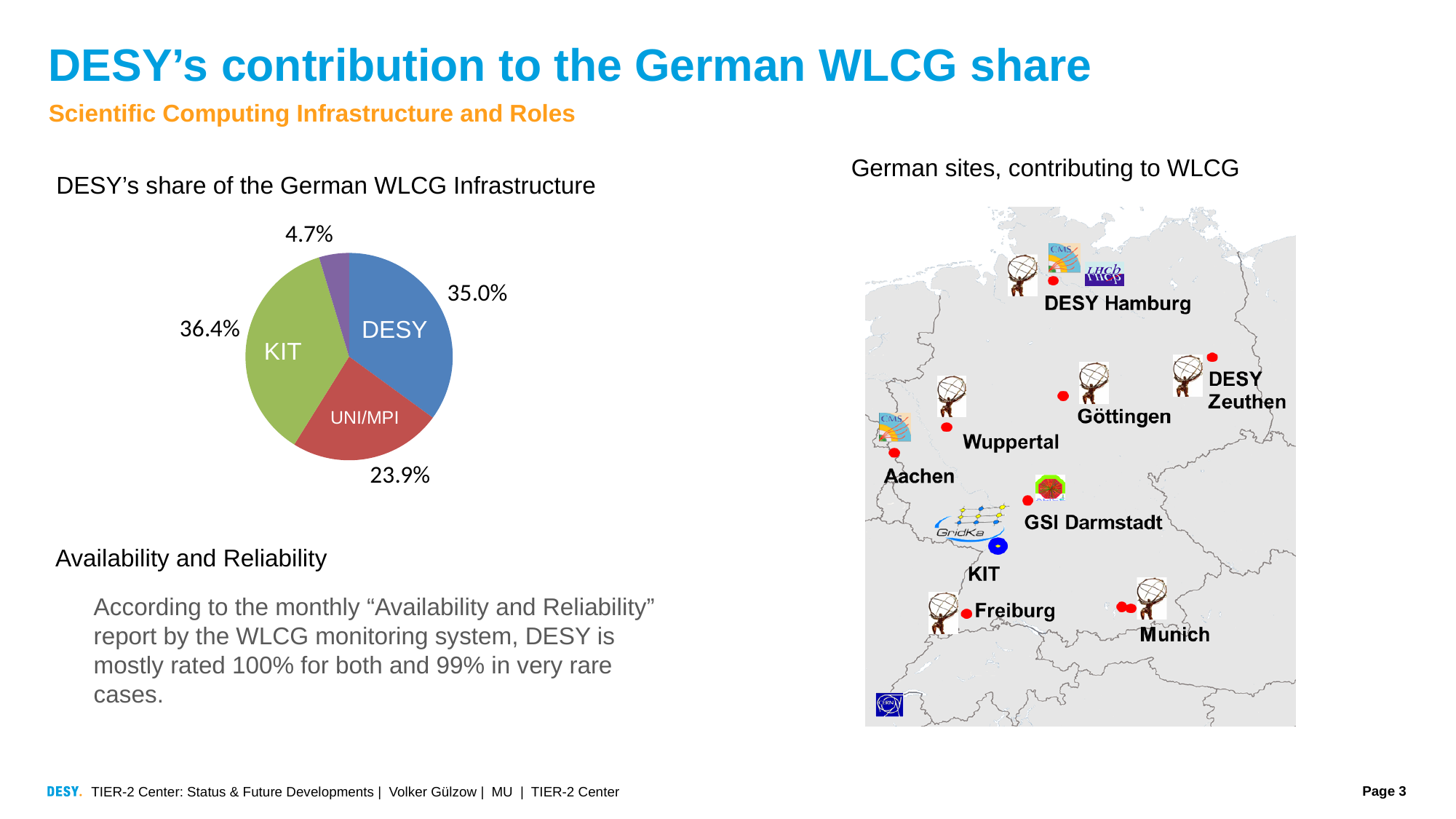
How many slices does the pie chart have? 4 What percentage is shown for UNI/MPI in the pie chart? 23.9% What is the difference between the DESY share and the UNI/MPI share in the pie chart? 11.1% Which labelled slice of the pie chart has the largest share? KIT What percentage is shown for KIT in the pie chart? 36.4% What is the difference between the KIT share and the DESY share in the pie chart? 1.4% What is the title of the pie chart on the slide? DESY's share of the German WLCG Infrastructure What share of the German WLCG Infrastructure does DESY hold according to the pie chart? 35.0% What is the smallest percentage shown on the pie chart? 4.7% Which has the larger share in the pie chart, DESY or UNI/MPI? DESY What is the combined share of DESY, KIT and UNI/MPI in the pie chart? 95.3% What kind of chart is shown under "DESY's share of the German WLCG Infrastructure"? pie chart